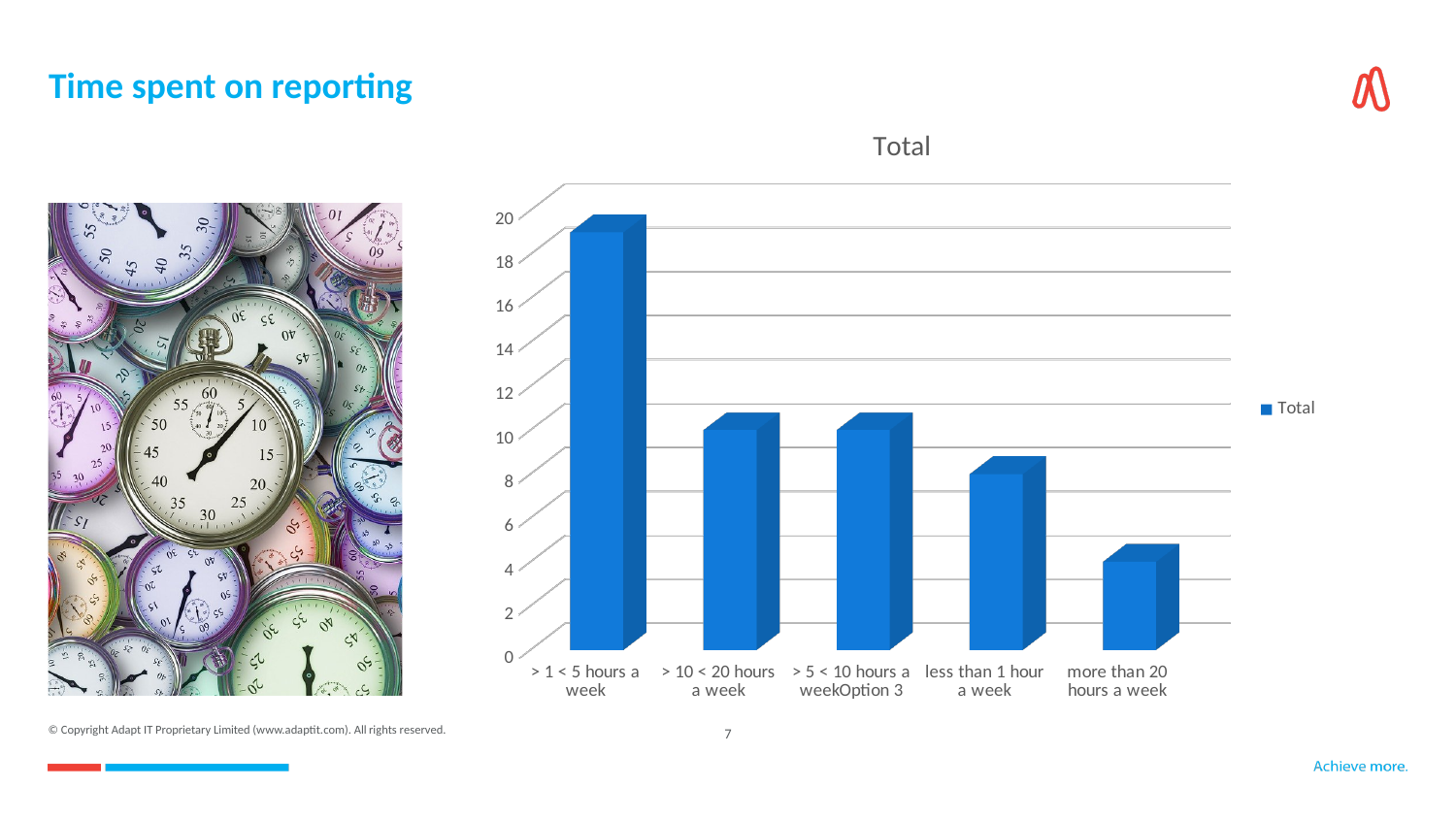
Is the value for "> 10 < 20 hours a week" greater or less than 8? greater Is the value for "more than 20 hours a week" greater or less than 6? less What kind of chart is shown on the slide? bar chart Is the value for "> 1 < 5 hours a week" greater or less than 16? greater Which category has the highest value in the chart? > 1 < 5 hours a week What is the name of the series shown in the chart's legend? Total Which is larger: the value for "less than 1 hour a week" or the value for "more than 20 hours a week"? less than 1 hour a week How many categories are shown on the x axis of the chart? 5 Which category has the lowest value in the chart? more than 20 hours a week How many series does the chart's legend list? 1 What is the title of the chart? Total